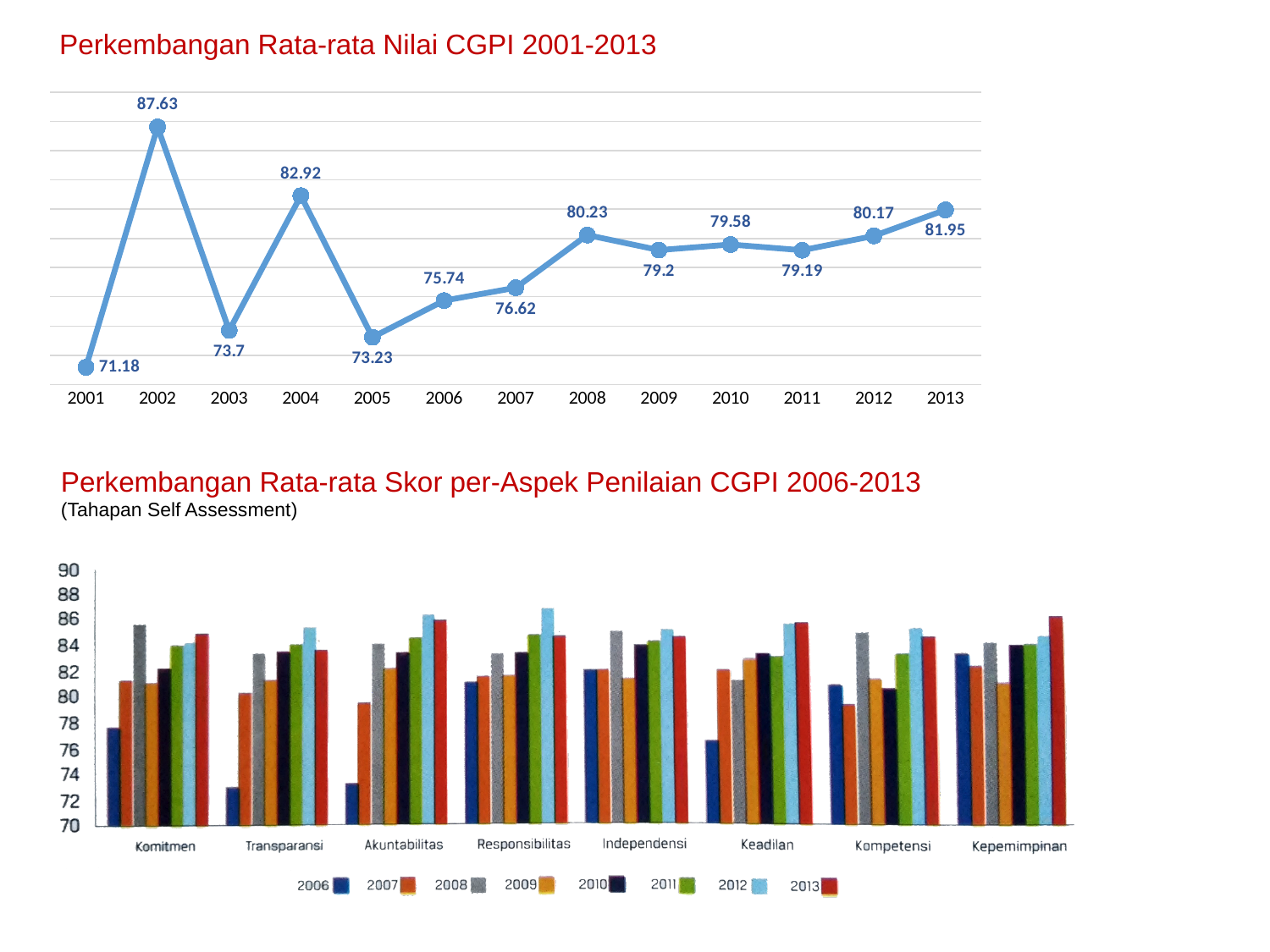
In the bottom chart 'Perkembangan Rata-rata Skor per-Aspek Penilaian CGPI 2006-2013', how many aspect categories are shown on the x axis? 8 In the bottom chart 'Perkembangan Rata-rata Skor per-Aspek Penilaian CGPI 2006-2013', how many series does the legend list? 8 In the top chart 'Perkembangan Rata-rata Nilai CGPI 2001-2013', what is the value for 2013? 81.95 In the top chart 'Perkembangan Rata-rata Nilai CGPI 2001-2013', which is larger, the value for 2004 or the value for 2008? 2004 What kind of chart is the bottom chart 'Perkembangan Rata-rata Skor per-Aspek Penilaian CGPI 2006-2013'? bar chart In the bottom chart 'Perkembangan Rata-rata Skor per-Aspek Penilaian CGPI 2006-2013', is the 2006 value for Transparansi greater or less than 76? less In the top chart 'Perkembangan Rata-rata Nilai CGPI 2001-2013', which year has the highest value? 2002 In the top chart 'Perkembangan Rata-rata Nilai CGPI 2001-2013', how many years are plotted? 13 In the top chart 'Perkembangan Rata-rata Nilai CGPI 2001-2013', what is the difference between the values for 2002 and 2001? 16.45 In the top chart 'Perkembangan Rata-rata Nilai CGPI 2001-2013', what is the value for 2002? 87.63 In the top chart 'Perkembangan Rata-rata Nilai CGPI 2001-2013', which year has the lowest value? 2001 What kind of chart is the top chart 'Perkembangan Rata-rata Nilai CGPI 2001-2013'? line chart